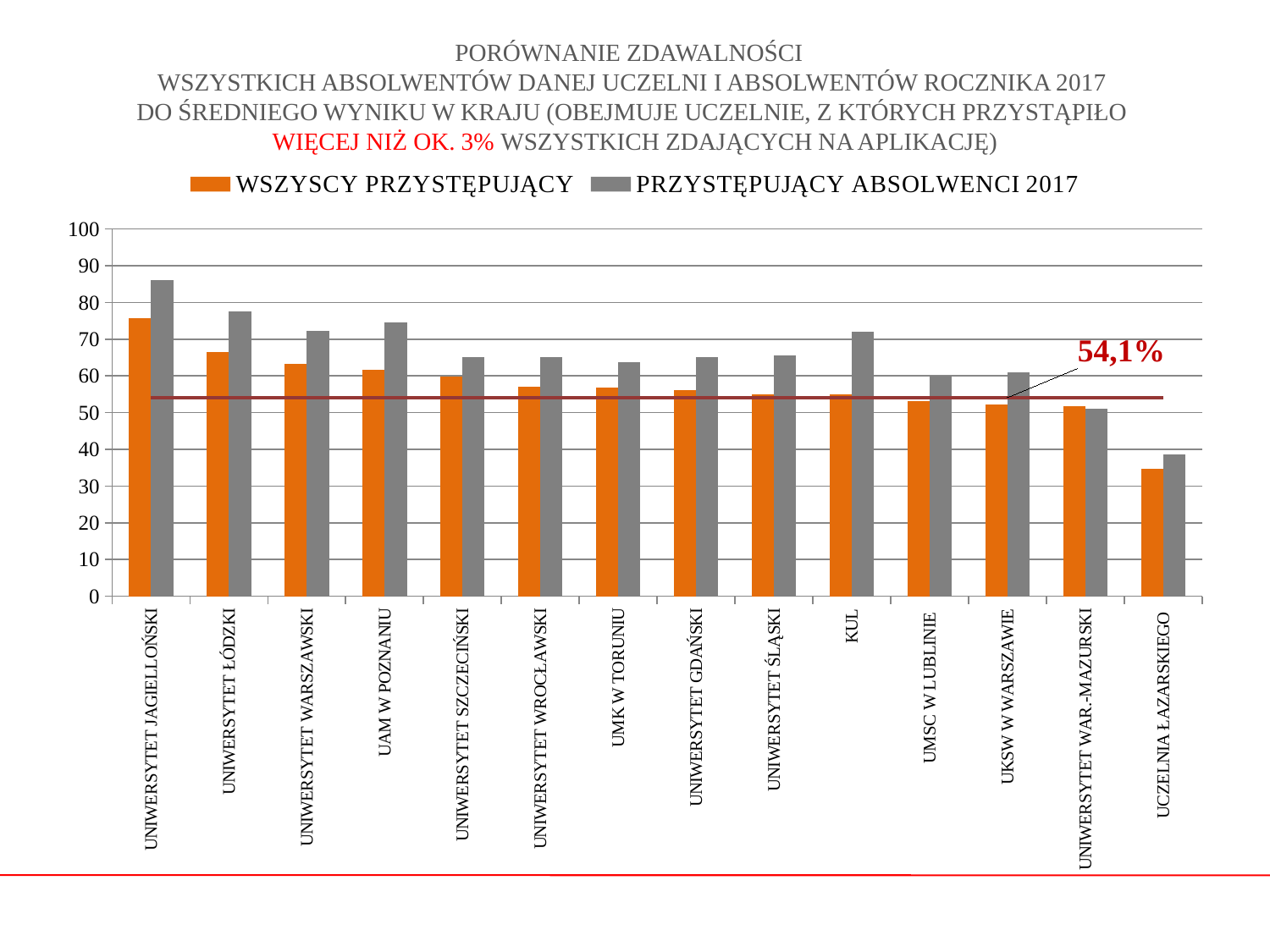
How many universities are shown on the x axis? 14 Which series is shown in orange according to the legend? WSZYSCY PRZYSTĘPUJĄCY Is the PRZYSTĘPUJĄCY ABSOLWENCI 2017 value for UCZELNIA ŁAZARSKIEGO greater or less than 50? less What value is labelled on the horizontal reference line in the chart? 54,1% For KUL, which series has the larger value: WSZYSCY PRZYSTĘPUJĄCY or PRZYSTĘPUJĄCY ABSOLWENCI 2017? PRZYSTĘPUJĄCY ABSOLWENCI 2017 What kind of chart is shown on the slide? bar chart Which university has the highest value for PRZYSTĘPUJĄCY ABSOLWENCI 2017? UNIWERSYTET JAGIELLOŃSKI Which university has the lowest value for WSZYSCY PRZYSTĘPUJĄCY? UCZELNIA ŁAZARSKIEGO Is the WSZYSCY PRZYSTĘPUJĄCY value for UNIWERSYTET JAGIELLOŃSKI greater or less than 70? greater Which has the larger PRZYSTĘPUJĄCY ABSOLWENCI 2017 value: UNIWERSYTET JAGIELLOŃSKI or UNIWERSYTET ŁÓDZKI? UNIWERSYTET JAGIELLOŃSKI Is the PRZYSTĘPUJĄCY ABSOLWENCI 2017 value for UAM W POZNANIU greater or less than 70? greater How many series does the legend list? 2